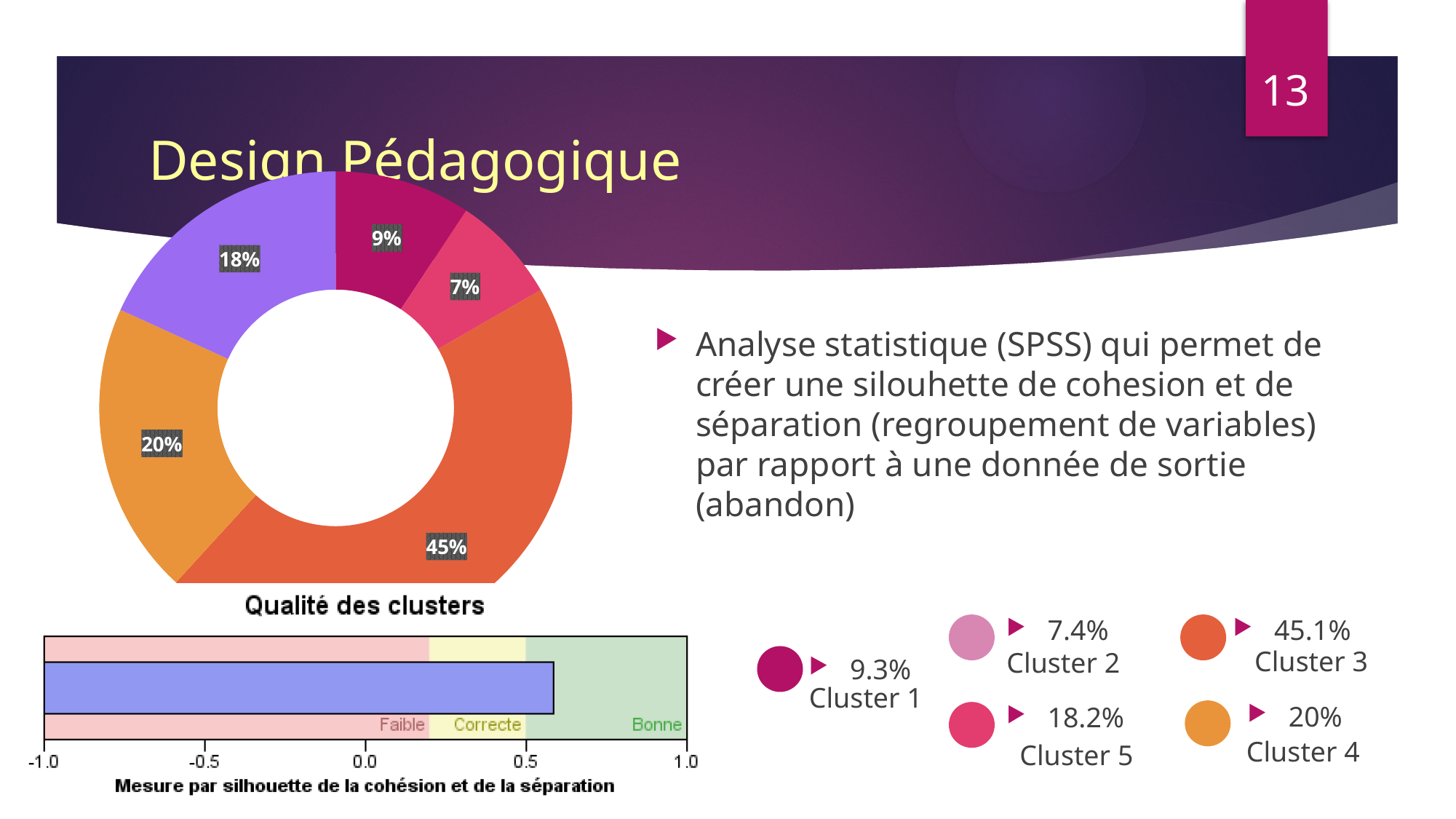
In the donut chart, what is the smallest slice's printed percentage? 7% According to the legend on the right, what share does Cluster 2 have? 7.4% In the donut chart, what is the difference between the 45% slice and the 20% slice? 25% What is the x-axis label of the 'Qualité des clusters' bar chart? Mesure par silhouette de la cohésion et de la séparation According to the legend on the right, which cluster has the largest share? Cluster 3 In the donut chart, what percentage is printed on the orange slice? 20% In the 'Qualité des clusters' bar chart, is the bar's value greater or less than 0.5? greater In the donut chart, what is the largest slice's printed percentage? 45% What kind of chart is the chart at the top left of the slide? Donut (pie) chart In the donut chart, which is larger: the slice labelled 9% or the slice labelled 7%? The 9% slice In the donut chart, what percentage is printed on the purple slice? 18% How many slices does the donut chart have? 5